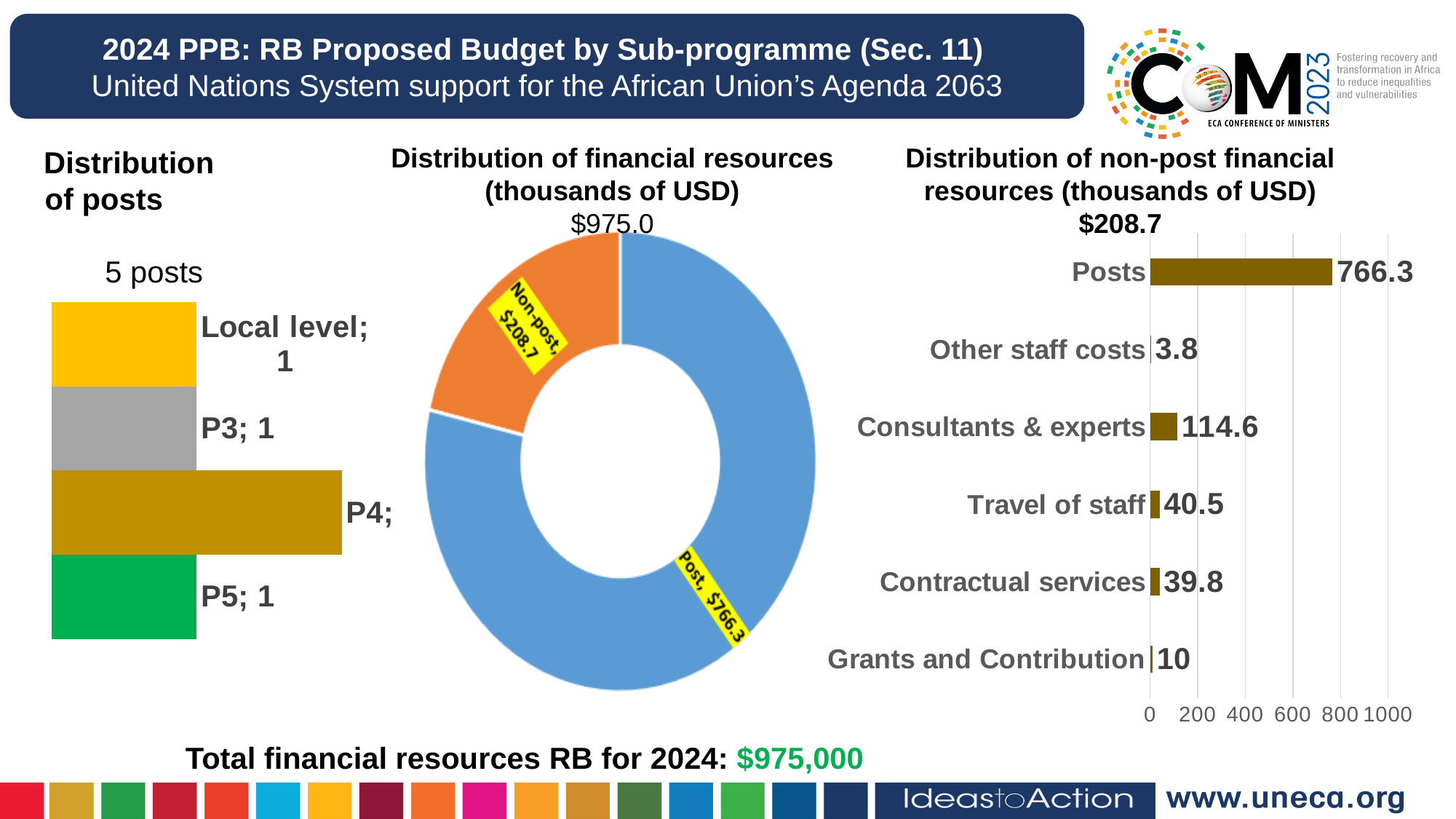
What kind of chart is the 'Distribution of financial resources (thousands of USD)' chart? doughnut chart In the 'Distribution of non-post financial resources' chart, what is the value for Consultants & experts? 114.6 In the 'Distribution of financial resources' chart, what is the value for Non-post? $208.7 How many categories are shown in the 'Distribution of non-post financial resources' chart? 6 In the 'Distribution of posts' chart, which category has the longest bar? P4 In the 'Distribution of non-post financial resources' chart, what is the difference between Travel of staff and Contractual services? 0.7 In the 'Distribution of non-post financial resources' chart, which category has the highest value? Posts In the 'Distribution of non-post financial resources' chart, is the value for Posts greater or less than 600? greater In the 'Distribution of non-post financial resources' chart, which is larger: Consultants & experts or Travel of staff? Consultants & experts In the 'Distribution of non-post financial resources' chart, which category has the lowest value? Other staff costs In the 'Distribution of financial resources' chart, what is the difference between Post and Non-post? 557.6 In the 'Distribution of non-post financial resources' chart, what is the value for Travel of staff? 40.5